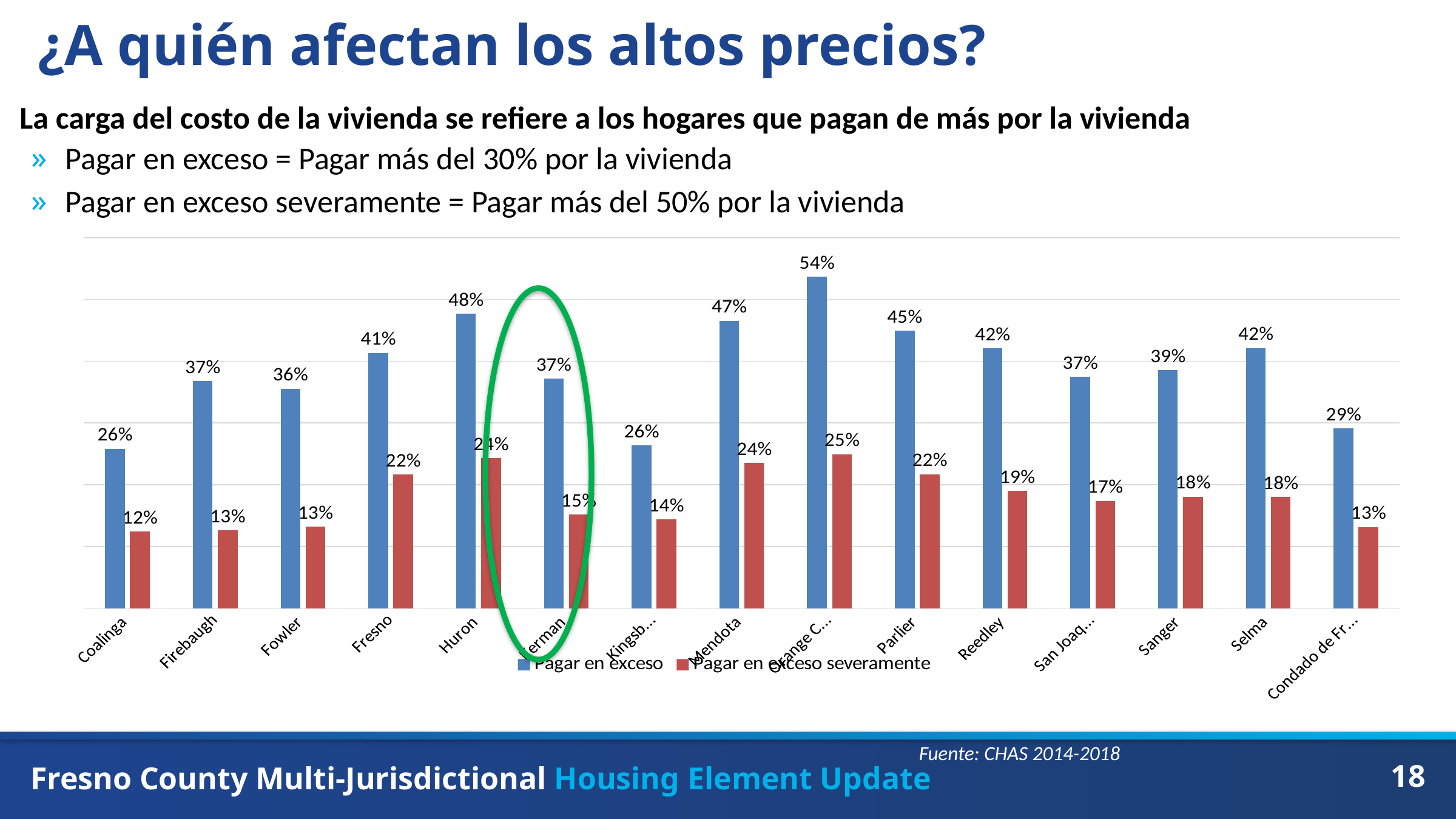
Which category has the highest 'Pagar en exceso' value? Orange C… What is the 'Pagar en exceso severamente' value for Fresno? 22% How many series does the chart legend list? 2 What is the 'Pagar en exceso' value for Kerman, the category circled in green? 37% What is the difference between the 'Pagar en exceso' and 'Pagar en exceso severamente' values for Huron? 24 percentage points Which colour represents the 'Pagar en exceso severamente' series in the chart? red Which has a higher 'Pagar en exceso' value, Reedley or Sanger? Reedley Which category has the lowest 'Pagar en exceso severamente' value? Coalinga What type of chart is shown on the slide? bar chart What is the 'Pagar en exceso' value for Huron? 48% What is the 'Pagar en exceso severamente' value for Selma? 18% How many categories (jurisdictions) are shown on the x axis of the chart? 15